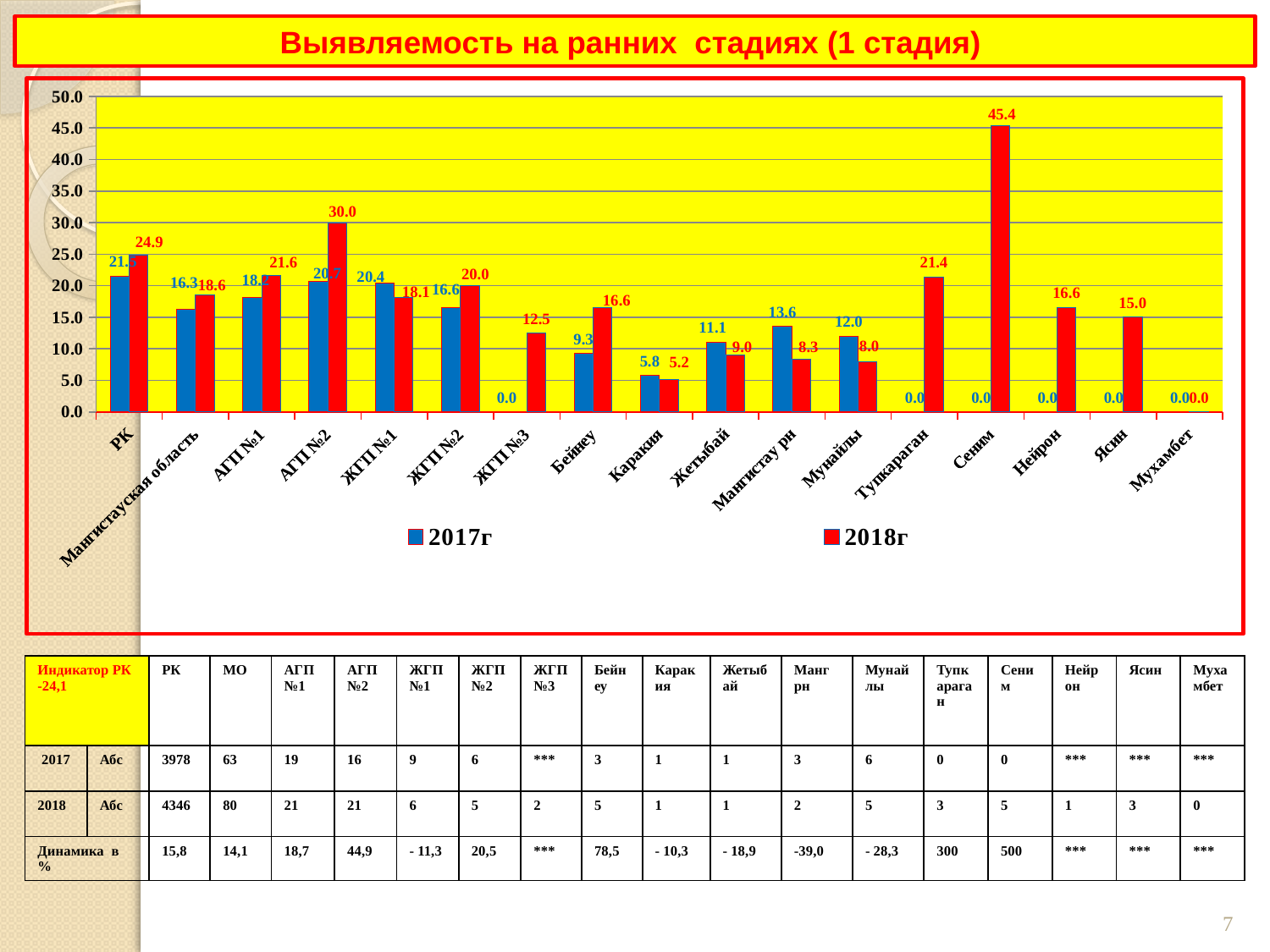
What is the 2017г value for Бейнеу? 9.3 What is the difference between the 2017г and 2018г values for Мунайлы? 4.0 How many series does the chart legend list? 2 How many categories are shown on the x axis of the chart? 17 Which category has the highest 2018г value? Сеним What type of chart is shown on the slide? Bar chart What is the 2018г value for АГП №2? 30.0 What is the difference between the 2018г and 2017г values for Тупкараган? 21.4 What is the 2018г value for Сеним? 45.4 Which is larger for ЖГП №1: the 2017г value or the 2018г value? 2017г What is the 2017г value for Мангистау рн? 13.6 Which category has the lowest 2018г value? Мухамбет